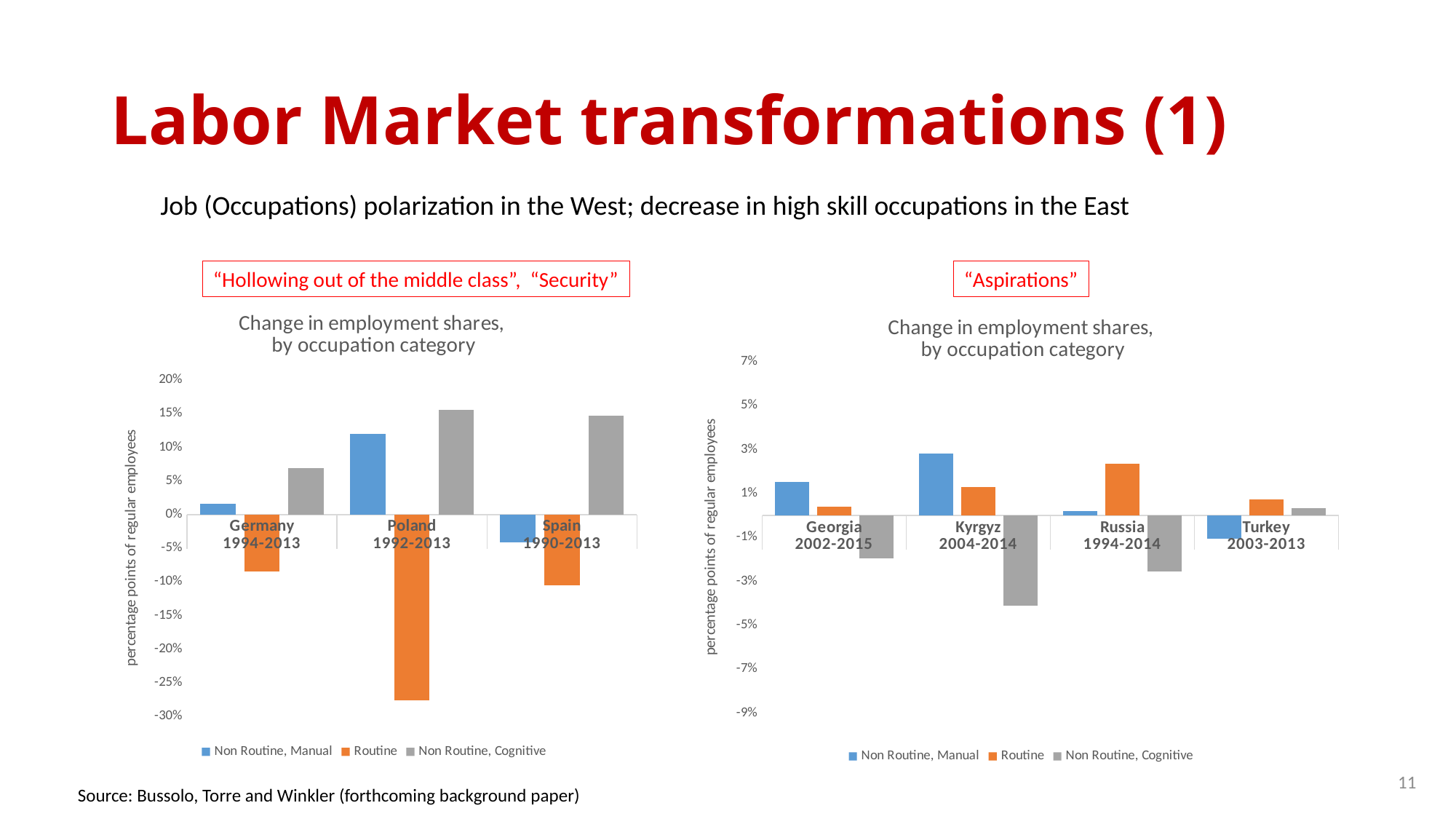
On the right chart, which is larger for Georgia 2002-2015: the Non Routine, Manual value or the Routine value? Non Routine, Manual How many countries are shown on the left chart? 3 On the left chart, is the Non Routine, Manual value for Poland 1992-2013 greater or less than 10%? greater On the right chart, is the Non Routine, Cognitive value for Kyrgyz 2004-2014 greater or less than -3%? less How many series does the legend of the right chart list? 3 On the left chart, is the Routine value for Poland 1992-2013 greater or less than -25%? less What kind of chart is the left chart on the slide? bar chart On the right chart, which country has the highest Routine value? Russia 1994-2014 On the left chart, which country has the highest Non Routine, Manual value? Poland 1992-2013 On the left chart, which country has the lowest Routine value? Poland 1992-2013 How many countries are shown on the right chart? 4 On the right chart, which country has the lowest Non Routine, Cognitive value? Kyrgyz 2004-2014